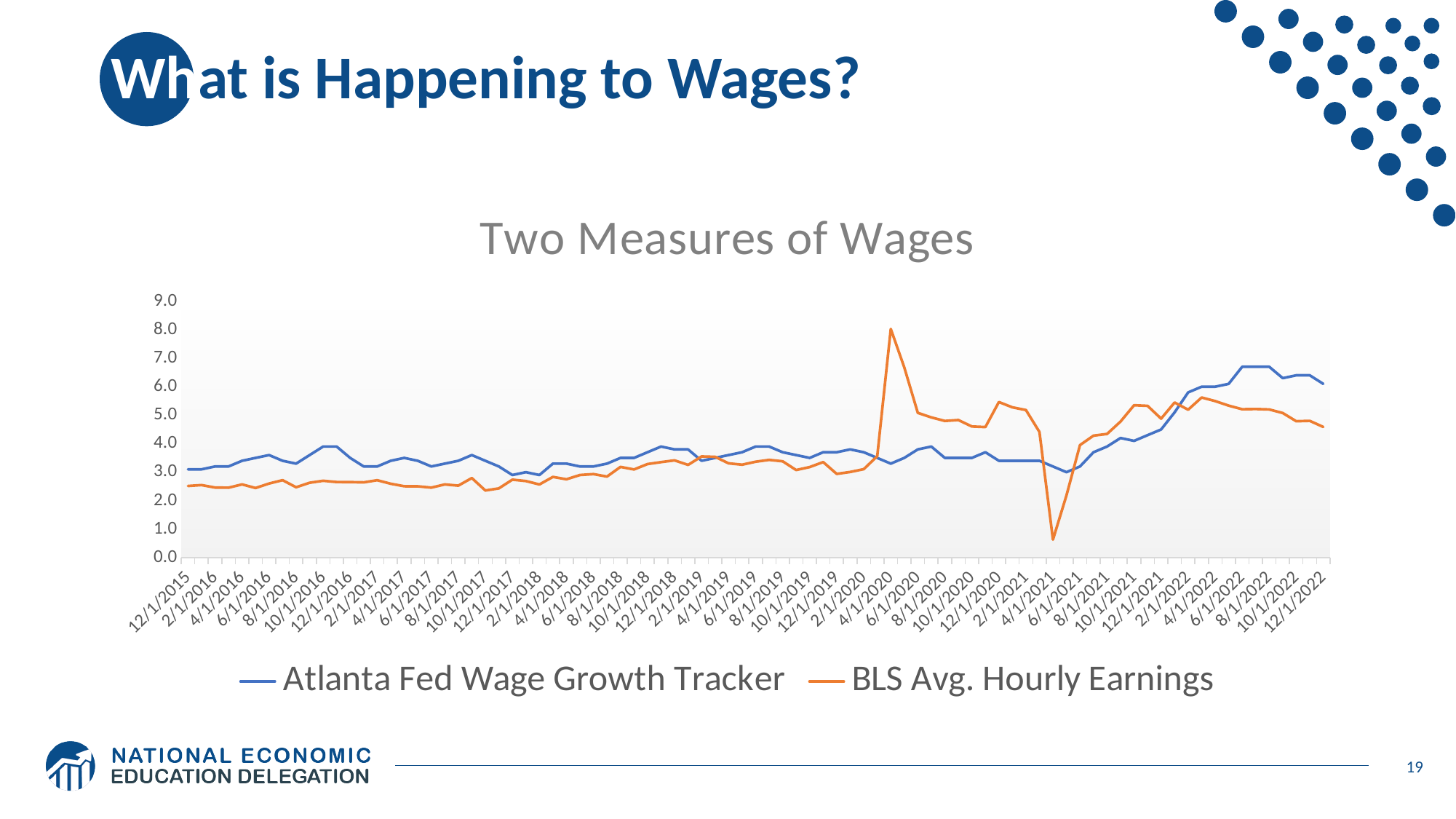
What kind of chart is shown on the slide? line chart Overall, does the Atlanta Fed Wage Growth Tracker rise or fall from 12/1/2015 to 12/1/2022? rise Which series reaches the lowest value anywhere on the chart? BLS Avg. Hourly Earnings Is the value of BLS Avg. Hourly Earnings at 12/1/2022 greater or less than 5.0? less Which series reaches the highest value anywhere on the chart? BLS Avg. Hourly Earnings Is the lowest value of BLS Avg. Hourly Earnings around 4/1/2021 greater or less than 1.0? less Is the peak value of BLS Avg. Hourly Earnings around 4/1/2020 greater or less than 7.0? greater Which series is drawn in orange? BLS Avg. Hourly Earnings What is the title of the chart? Two Measures of Wages At 4/1/2021, which series has the higher value, Atlanta Fed Wage Growth Tracker or BLS Avg. Hourly Earnings? Atlanta Fed Wage Growth Tracker How many series does the chart's legend list? 2